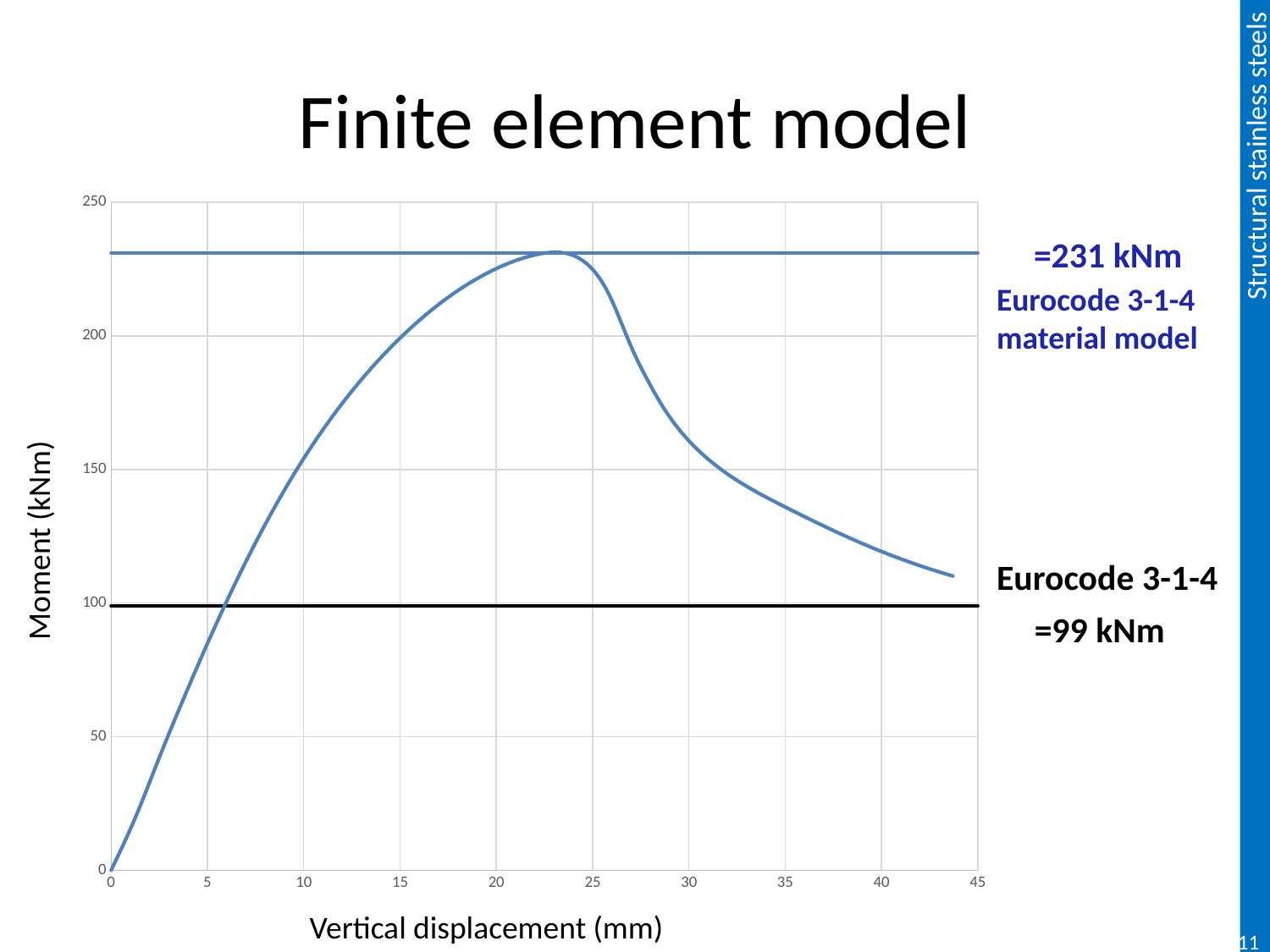
What moment value is marked by the black horizontal line labelled 'Eurocode 3-1-4'? 99 kNm Does the moment curve rise or fall as vertical displacement increases from 0 to 20 mm? rise What kind of chart is shown on the slide? line chart What moment value is marked by the blue horizontal line labelled 'Eurocode 3-1-4 material model'? 231 kNm What is the title of the slide containing the chart? Finite element model Is the peak of the moment curve greater or less than 250 kNm? less At a vertical displacement of 40 mm, is the moment on the curve greater or less than 150 kNm? less What is the difference between the 231 kNm line and the 99 kNm line? 132 kNm Is the peak of the moment curve greater or less than 200 kNm? greater What is the label of the vertical axis? Moment (kNm) Which horizontal reference line is higher: the Eurocode 3-1-4 material model line or the Eurocode 3-1-4 line? Eurocode 3-1-4 material model line